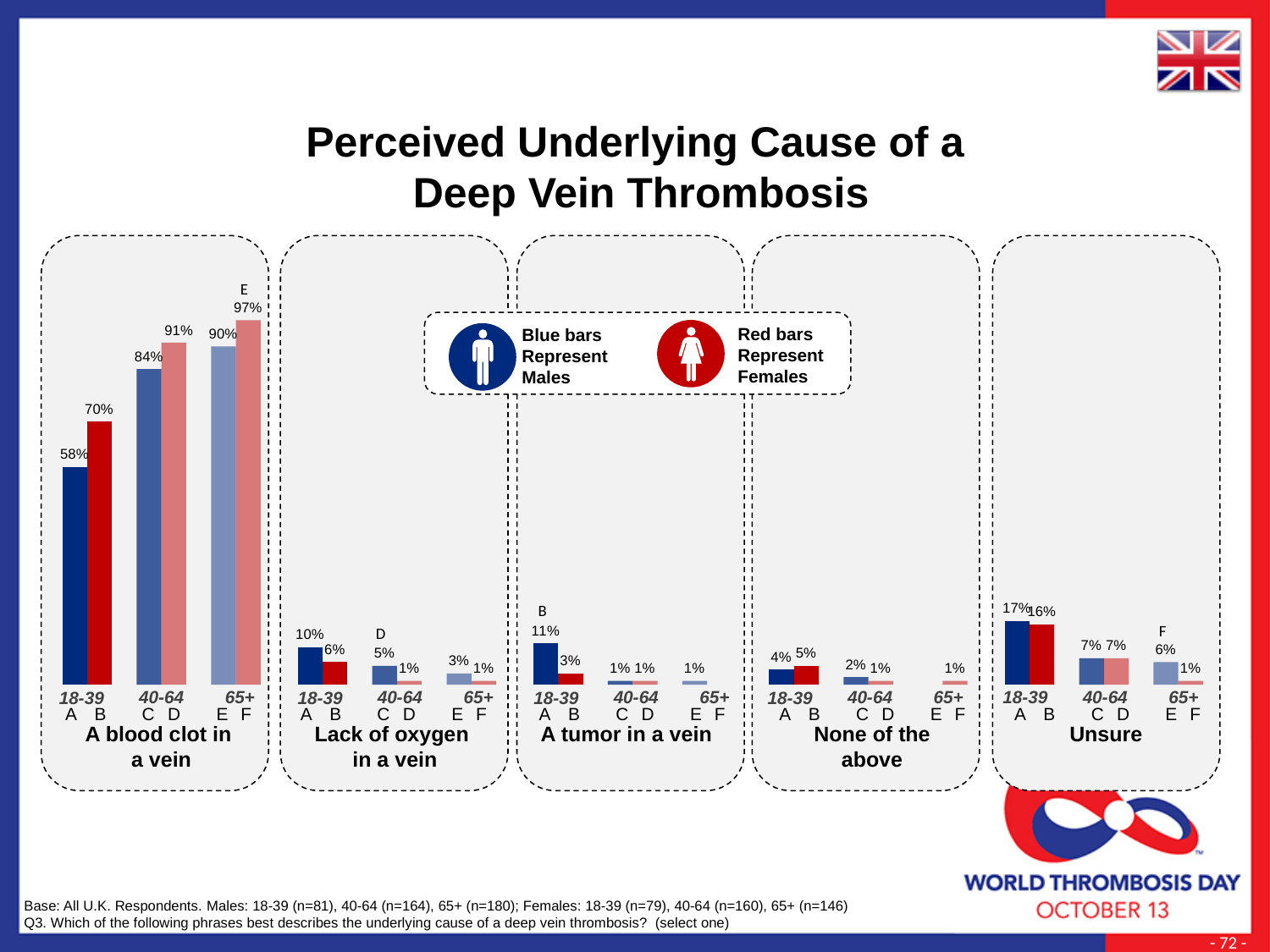
In the 'None of the above' chart, what is the value for females aged 18-39? 5% In the 'A blood clot in a vein' chart, what is the value for males aged 18-39? 58% In the 'Lack of oxygen in a vein' chart, what is the value for males aged 18-39? 10% In the 'Unsure' chart, what is the value for females aged 18-39? 16% According to the legend, what do the red bars represent? Females In the 'Lack of oxygen in a vein' chart, which is larger: males aged 40-64 or females aged 40-64? Males 40-64 In the 'A blood clot in a vein' chart, which group has the lowest value? Males 18-39 What type of chart is used on this slide? Bar chart In the 'A blood clot in a vein' chart, what is the difference between females aged 40-64 and males aged 40-64? 7% In the 'Unsure' chart, what is the difference between males aged 65+ and females aged 65+? 5% In the 'A tumor in a vein' chart, what is the value for males aged 18-39? 11% In the 'A blood clot in a vein' chart, what percentage of females aged 65+ chose this answer? 97%